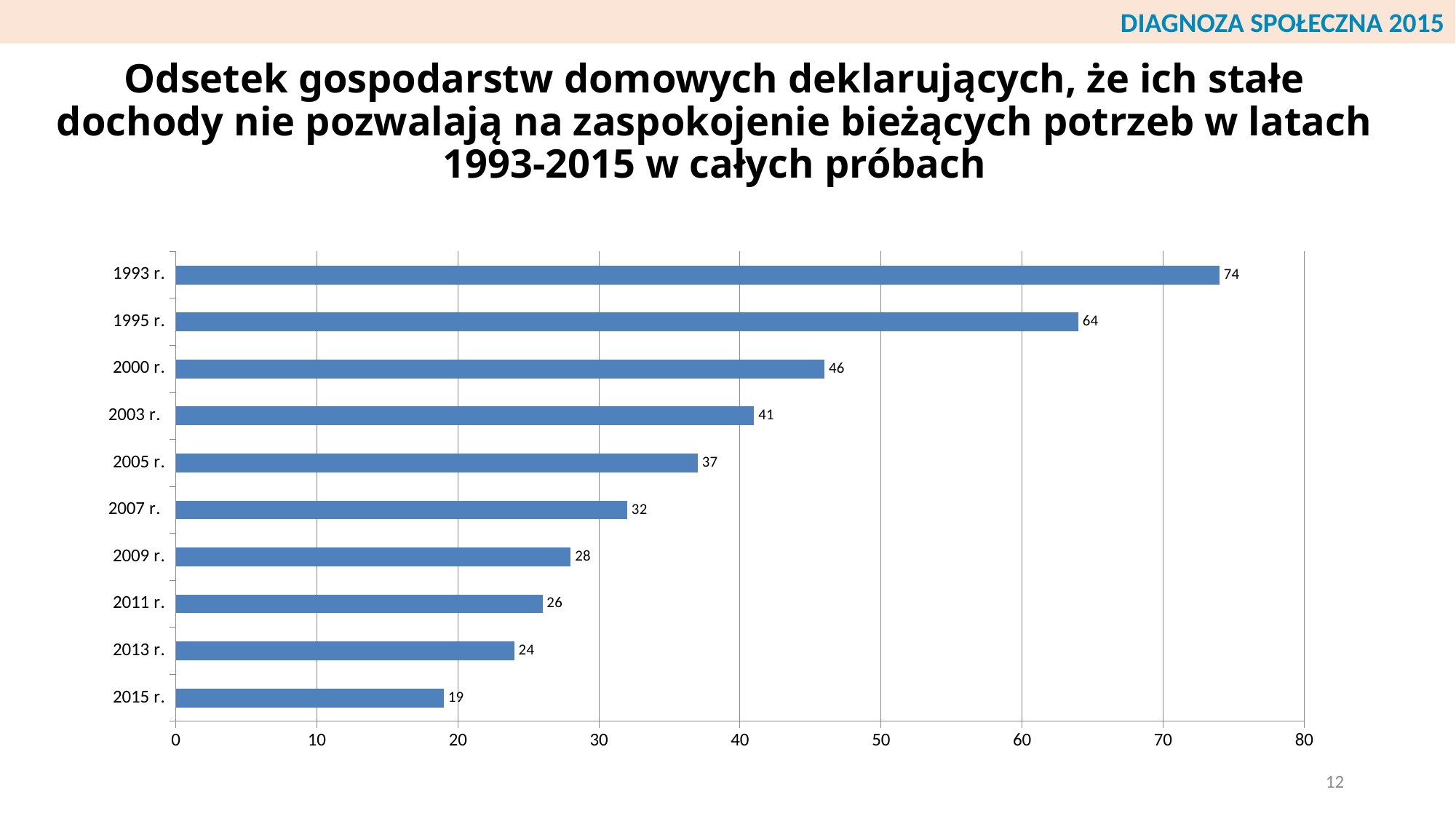
Is the value for 2003 r. greater or less than 40? greater What is the value for 2015 r.? 19 What is the difference between the values for 2000 r. and 2015 r.? 27 How many years are shown in the chart? 10 What is the value for 1993 r.? 74 Which year has the highest value? 1993 r. Which year has the lowest value? 2015 r. What kind of chart is shown on the slide? bar chart What is the difference between the values for 1993 r. and 1995 r.? 10 Do the values rise or fall from 1993 r. to 2015 r.? fall What is the value for 2005 r.? 37 Which is larger, the value for 2007 r. or the value for 2009 r.? 2007 r.